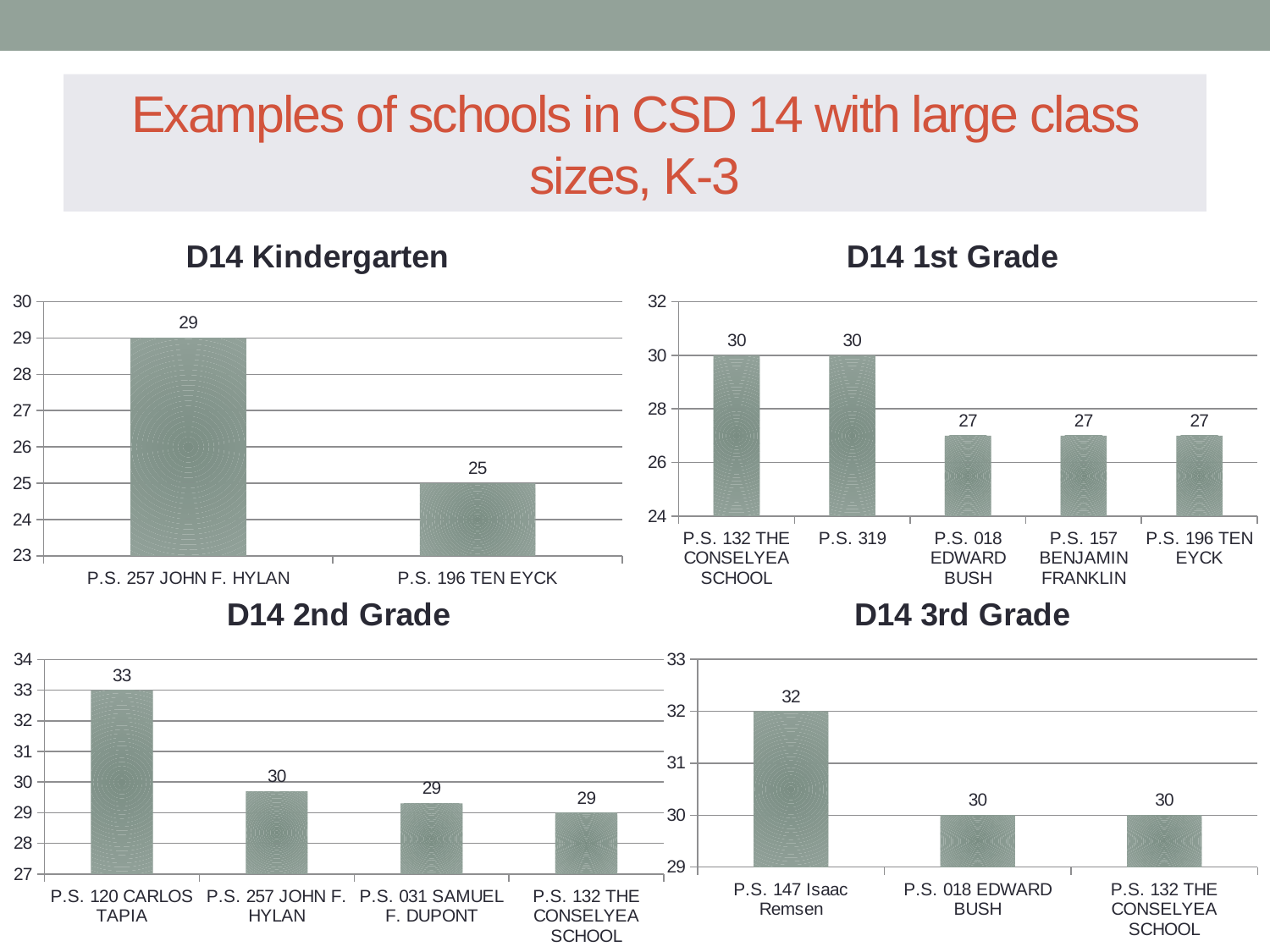
In the D14 3rd Grade chart, what is the value for P.S. 147 Isaac Remsen? 32 In the D14 3rd Grade chart, what is the difference between P.S. 147 Isaac Remsen and P.S. 018 EDWARD BUSH? 2 How many charts are on the slide? 4 What type of chart is the D14 3rd Grade chart? Bar chart In the D14 2nd Grade chart, what is the value for P.S. 031 SAMUEL F. DUPONT? 29 In the D14 1st Grade chart, which is larger, P.S. 319 or P.S. 196 TEN EYCK? P.S. 319 In the D14 2nd Grade chart, which school has the highest value? P.S. 120 CARLOS TAPIA In the D14 Kindergarten chart, what is the value for P.S. 257 JOHN F. HYLAN? 29 In the D14 Kindergarten chart, what is the difference between P.S. 257 JOHN F. HYLAN and P.S. 196 TEN EYCK? 4 How many schools are shown in the D14 1st Grade chart? 5 In the D14 1st Grade chart, what is the value for P.S. 018 EDWARD BUSH? 27 In the D14 2nd Grade chart, is the value for P.S. 120 CARLOS TAPIA greater or less than 32? greater